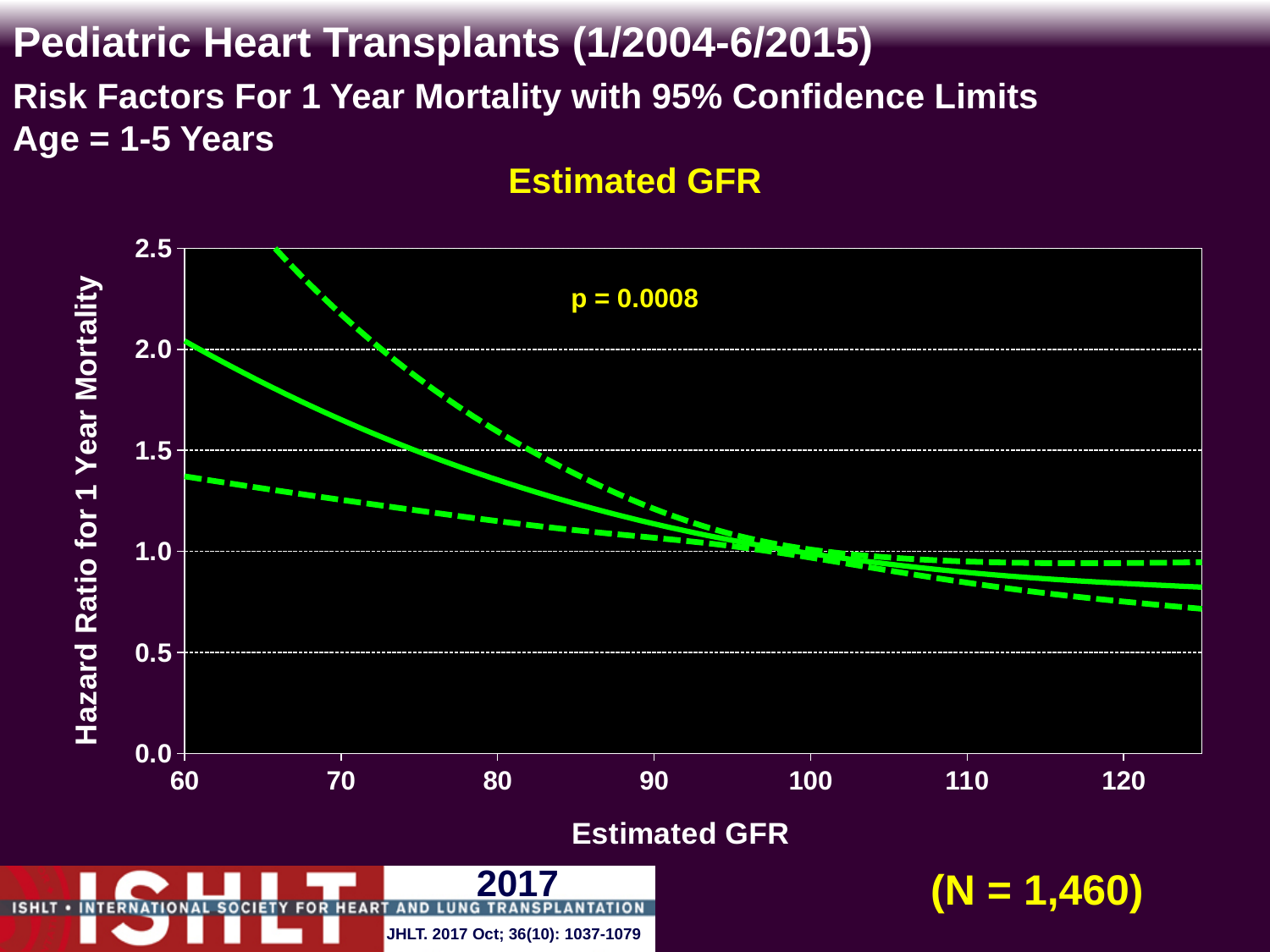
Does the solid hazard ratio line rise or fall as Estimated GFR increases from 60 to 120? fall What kind of chart is shown on the slide? line chart What p-value is printed on the chart? p = 0.0008 Is the hazard ratio on the solid line at an Estimated GFR of 70 greater or less than 1.5? greater What is the label of the y axis? Hazard Ratio for 1 Year Mortality What is the sample size N shown on the slide? 1,460 How many lines are plotted on the chart? 3 Is the upper dashed confidence limit at an Estimated GFR of 70 greater or less than 2.0? greater Is the lower dashed confidence limit at an Estimated GFR of 60 greater or less than 1.5? less